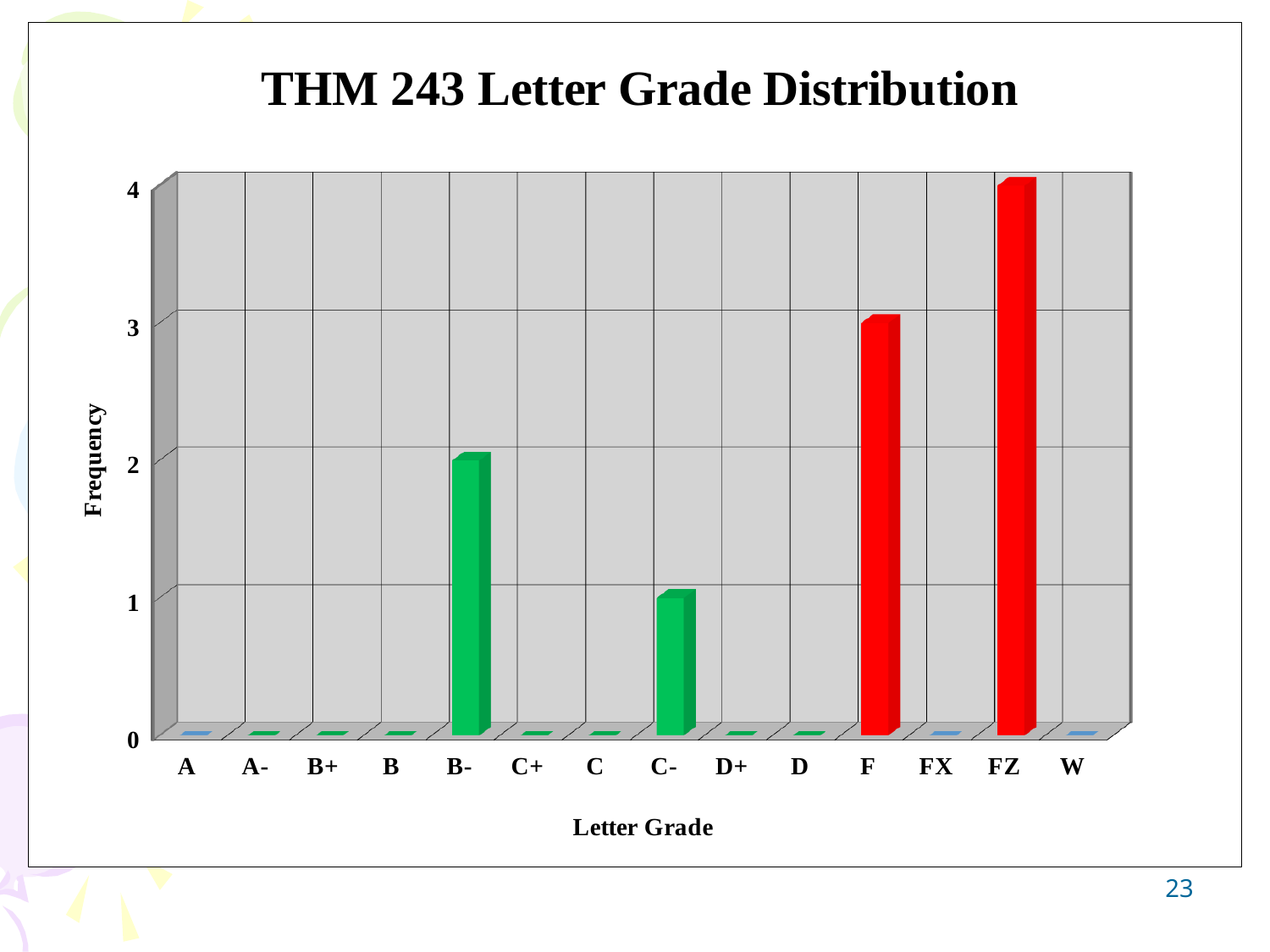
What is the difference in frequency between B- and C-? 1 What is the frequency for the C- grade? 1 What is the frequency for the F grade? 3 What is the frequency for the FZ grade? 4 How many letter grade categories are shown on the x axis? 14 What is the difference in frequency between FZ and F? 1 What kind of chart is shown on the slide? bar chart What is the label of the y axis? Frequency Which letter grade has the highest frequency? FZ Which has a higher frequency, B- or F? F What is the title of the chart? THM 243 Letter Grade Distribution What is the frequency for the B- grade? 2